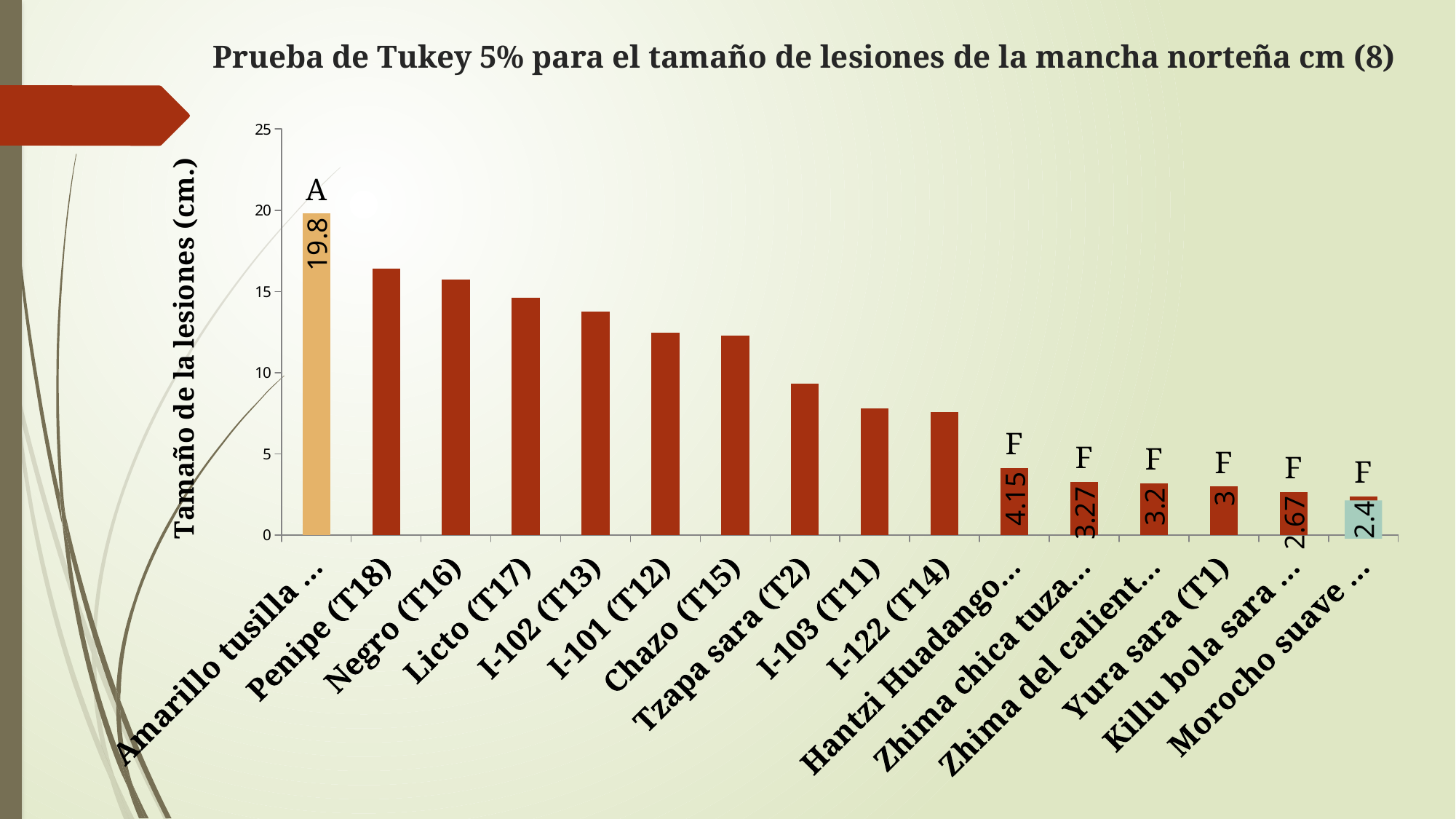
What is the value for the first bar (Amarillo tusilla)? 19.8 What is the value for Yura sara (T1)? 3 Which category has the highest lesion size? Amarillo tusilla Is the value for Penipe (T18) greater or less than 15? greater Is the value for Tzapa sara (T2) greater or less than 10? less Which category has the lowest lesion size? Morocho suave What is the value for the Hantzi Huadango bar? 4.15 What is the difference between the first bar (19.8) and the last bar (2.4)? 17.4 Do the values rise or fall from left to right along the x axis? fall What is the difference between Yura sara (T1) and Killu bola sara? 0.33 What is the value for the last bar (Morocho suave)? 2.4 How many bars are shown in the chart? 16